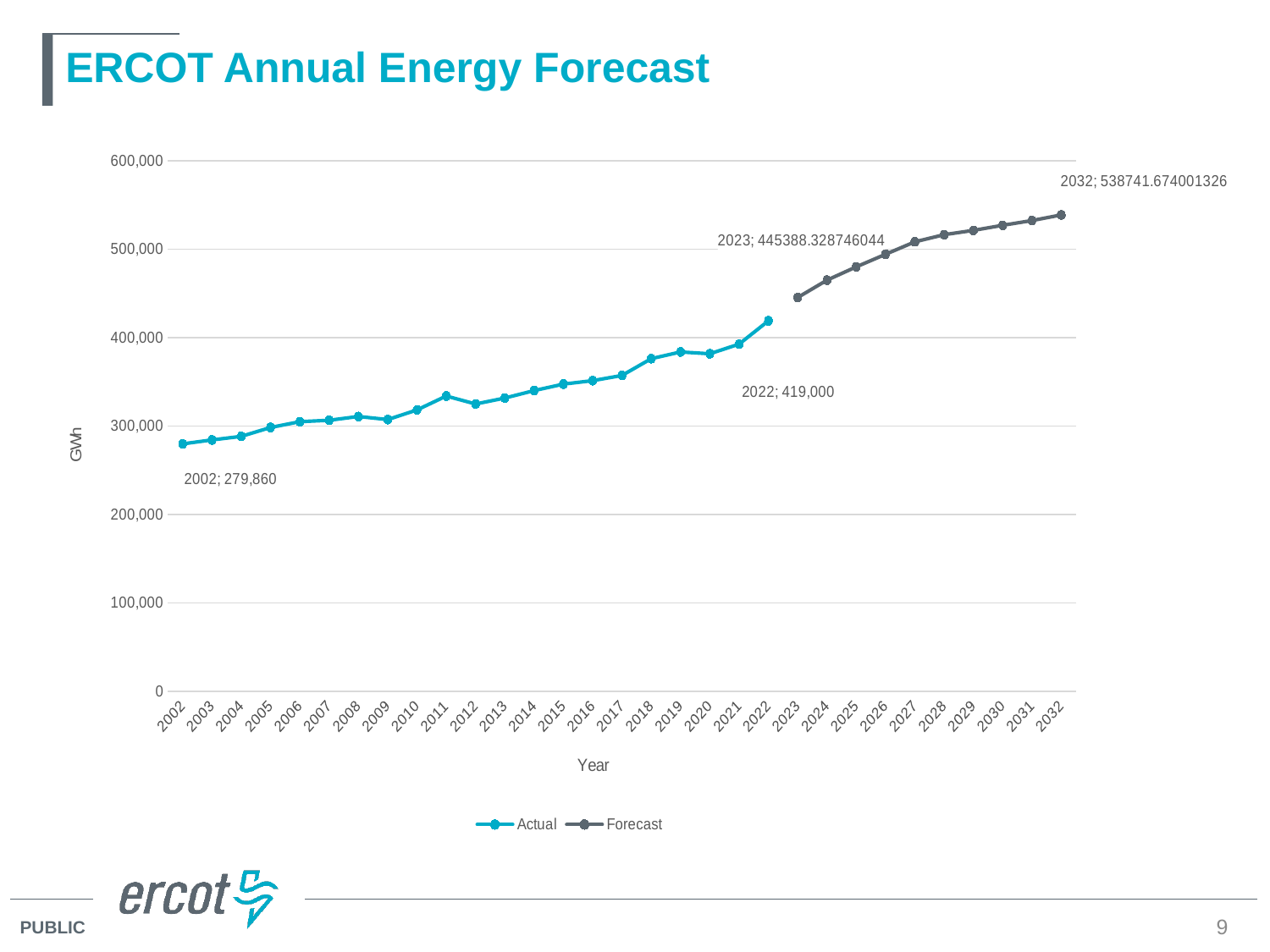
Is the value for 2018 greater or less than 400,000? less What is the difference between the 2022 value and the 2002 value? 139,140 Which year has the lowest value on the chart? 2002 How many series does the legend list? 2 What is the value for 2022 on the chart? 419,000 What is the value for 2002 on the ERCOT Annual Energy Forecast chart? 279,860 What value is labelled for 2023 on the chart? 445388.328746044 What value is labelled for 2032 on the chart? 538741.674001326 What kind of chart is shown on the slide? line chart Which year has the highest value on the chart? 2032 Is the value for 2028 greater or less than 500,000? greater What unit is shown on the y-axis label? GWh